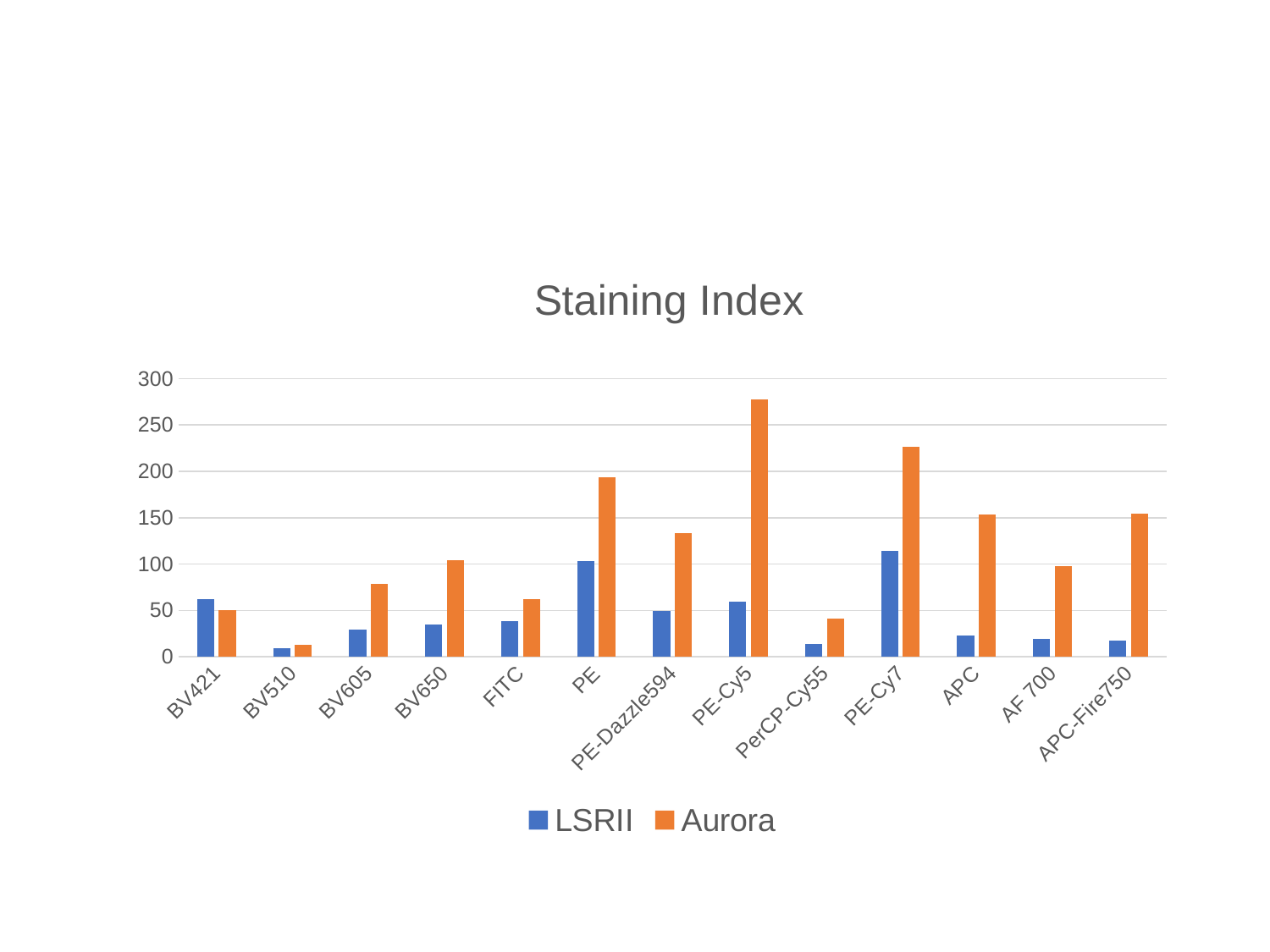
Which category has the lowest Aurora value? BV510 For BV421, which series has the larger value, LSRII or Aurora? LSRII What kind of chart is shown on the slide? bar chart Is the Aurora value for PE-Cy5 greater or less than 250? greater Is the Aurora value for PE-Cy7 greater or less than 200? greater Is the LSRII value for APC greater or less than 50? less What is the title of the chart? Staining Index How many series does the legend list? 2 Which category has the highest Aurora value? PE-Cy5 Which has the larger Aurora value, PE or PE-Cy7? PE-Cy7 How many categories are shown on the x axis? 13